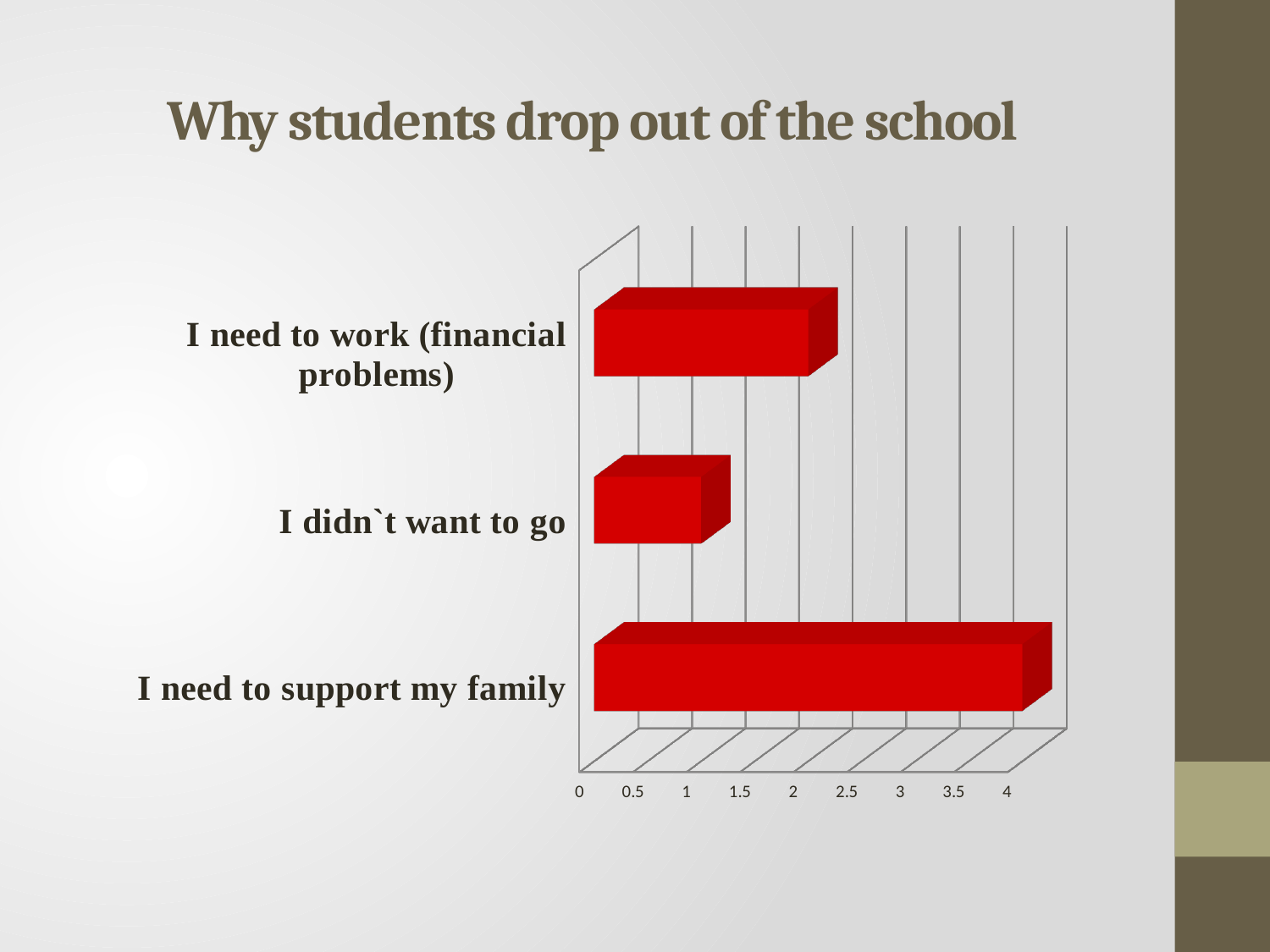
Which reason has the lowest value in the chart? I didn`t want to go Is the value for "I need to work (financial problems)" greater or less than 3? less Is the value for "I didn`t want to go" greater or less than 2? less Which has the larger value: "I need to work (financial problems)" or "I didn`t want to go"? I need to work (financial problems) Is the value for "I need to support my family" greater or less than 3? greater What colour are the bars in the chart? red Which reason has the highest value in the chart? I need to support my family What is the title of the slide containing the chart? Why students drop out of the school How many categories (reasons) does the chart show? 3 Which has the larger value: "I need to support my family" or "I need to work (financial problems)"? I need to support my family What kind of chart is shown on the slide? bar chart